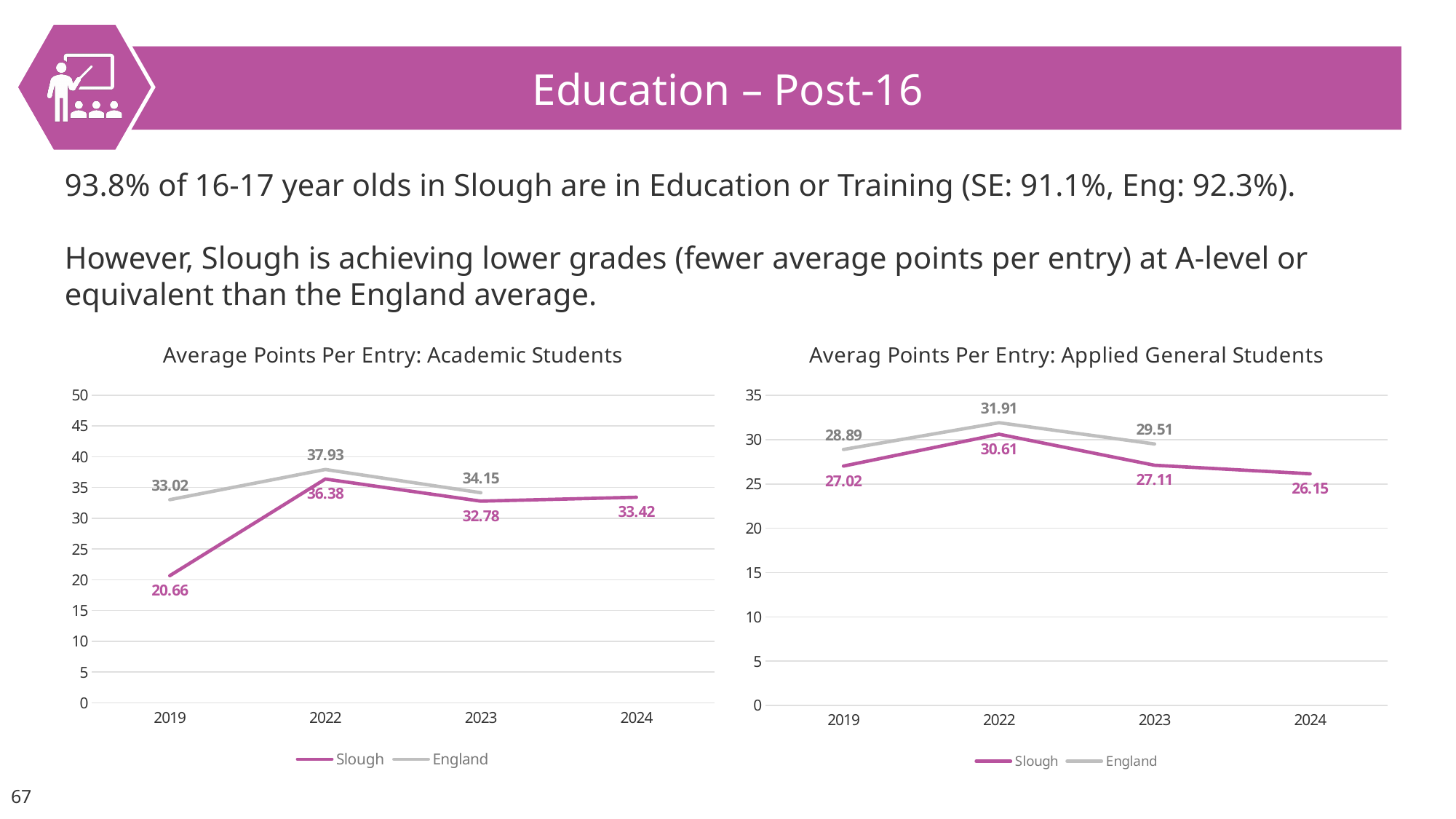
In the 'Averag Points Per Entry: Applied General Students' chart, which year has the lowest value for Slough? 2024 In the 'Average Points Per Entry: Academic Students' chart, what is the value for England in 2022? 37.93 In the 'Average Points Per Entry: Academic Students' chart, how many years are shown on the x axis? 4 In the 'Averag Points Per Entry: Applied General Students' chart, what is the value for England in 2023? 29.51 In the 'Averag Points Per Entry: Applied General Students' chart, what is the value for Slough in 2024? 26.15 In the 'Averag Points Per Entry: Applied General Students' chart, what is the difference between England and Slough in 2022? 1.30 In the 'Average Points Per Entry: Academic Students' chart, which year has the highest value for Slough? 2022 In the 'Average Points Per Entry: Academic Students' chart, what is the difference between England and Slough in 2019? 12.36 In the 'Average Points Per Entry: Academic Students' chart, is the value for Slough in 2024 greater or less than 30? greater In the 'Averag Points Per Entry: Applied General Students' chart, how many series does the legend list? 2 In the 'Average Points Per Entry: Academic Students' chart, what is the value for Slough in 2019? 20.66 What type of chart is the 'Averag Points Per Entry: Applied General Students' chart? Line chart